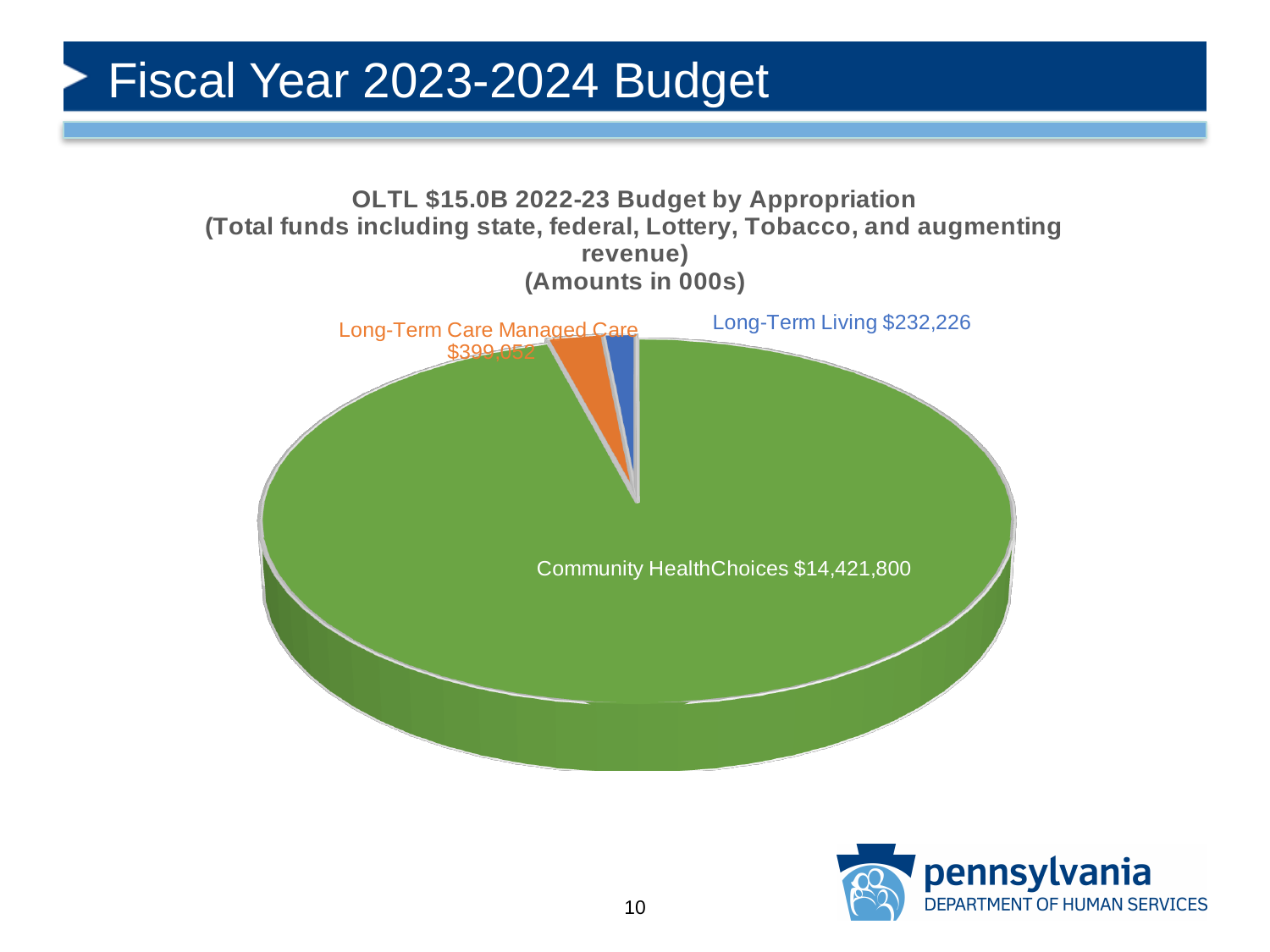
How much larger is the Community HealthChoices value than the Long-Term Living value? $14,189,574 What is the value shown for Long-Term Living? $232,226 What is the difference between the Long-Term Care Managed Care value and the Long-Term Living value? $166,826 Which appropriation has the smallest slice of the pie? Long-Term Living What is the value shown for Long-Term Care Managed Care? $399,052 What colour is the Community HealthChoices slice? Green What is the value shown for Community HealthChoices? $14,421,800 What kind of chart is shown on the slide? Pie chart How many slices does the pie chart have? 3 Which is larger, Long-Term Care Managed Care or Long-Term Living? Long-Term Care Managed Care Which appropriation has the largest slice of the pie? Community HealthChoices What is the first line of the chart's title? OLTL $15.0B 2022-23 Budget by Appropriation